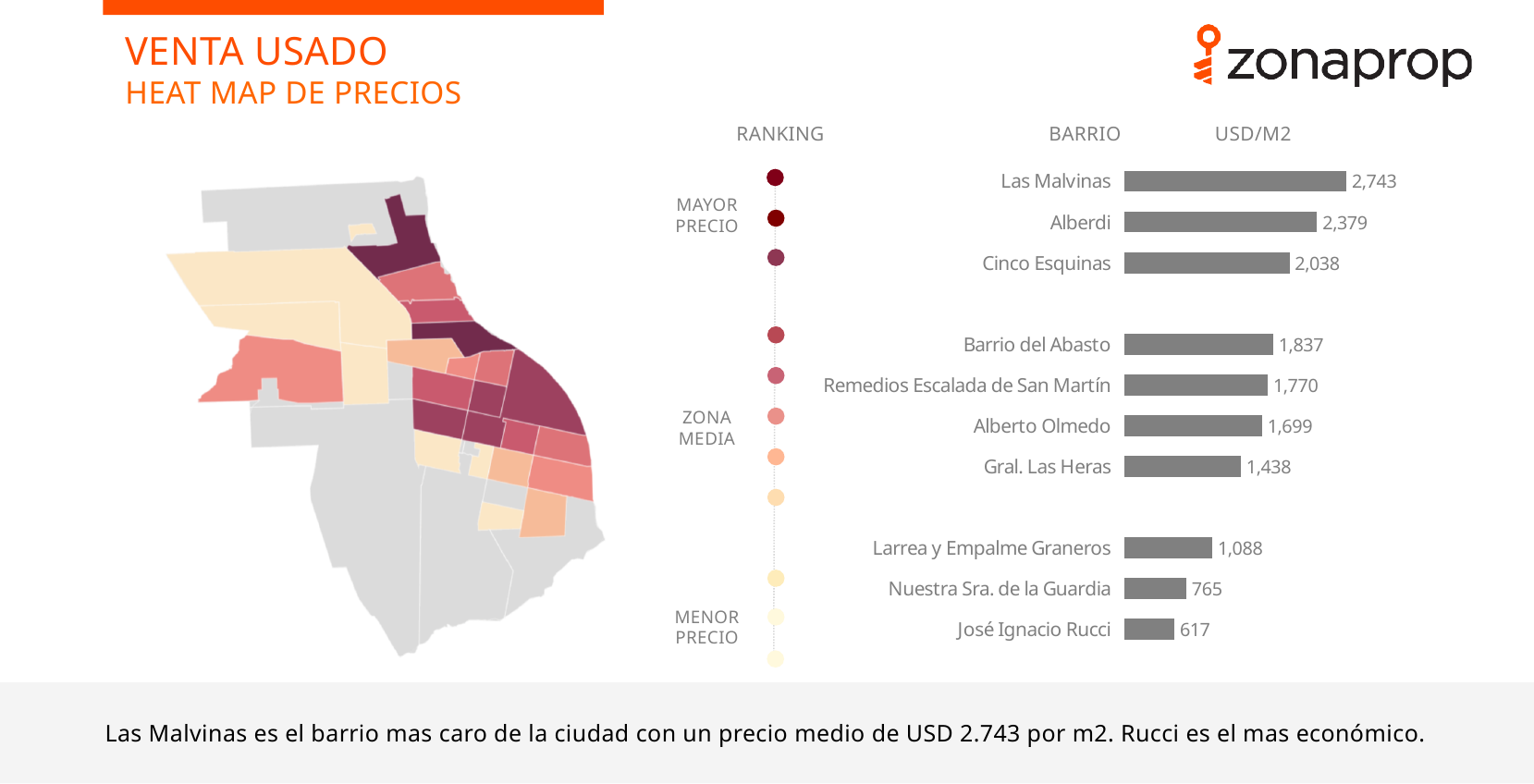
What is the USD/M2 value for Nuestra Sra. de la Guardia? 765 What is the title of the slide? VENTA USADO HEAT MAP DE PRECIOS Which has a higher USD/M2 value, Barrio del Abasto or Gral. Las Heras? Barrio del Abasto Which barrio has the lowest USD/M2 value? José Ignacio Rucci What kind of chart shows the USD/M2 values by barrio? Bar chart How many barrios are shown in the bar chart? 10 What is the USD/M2 value for Las Malvinas? 2,743 What is the difference in USD/M2 between Alberdi and Cinco Esquinas? 341 What is the USD/M2 value for Alberdi? 2,379 Which barrio has the highest USD/M2 value? Las Malvinas What is the USD/M2 value for Gral. Las Heras? 1,438 What is the difference in USD/M2 between Las Malvinas and José Ignacio Rucci? 2,126